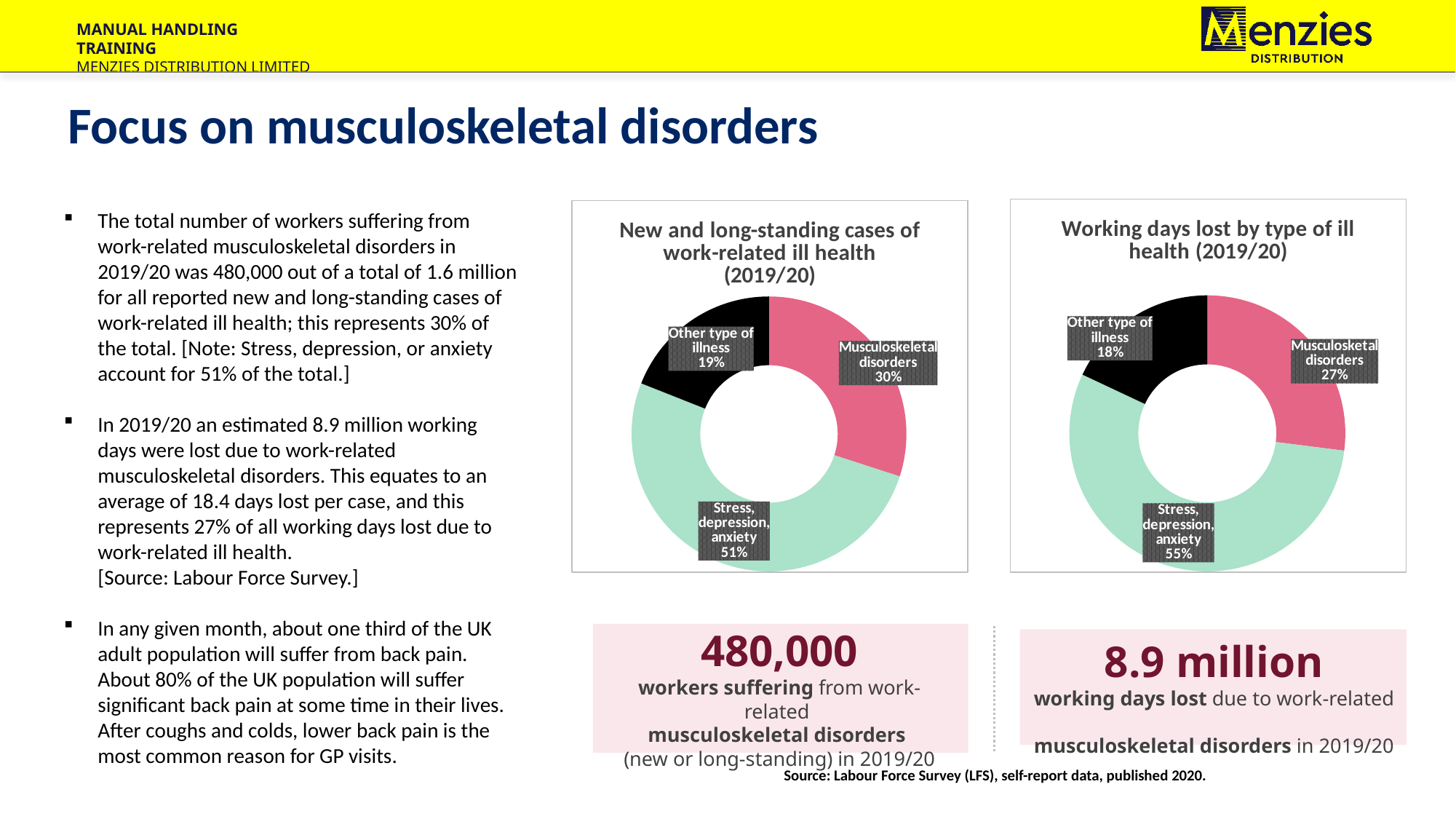
In the 'Working days lost by type of ill health (2019/20)' chart, what share is shown for Musculoskeletal disorders? 27% In the 'Working days lost by type of ill health (2019/20)' chart, which category has the smallest share? Other type of illness In the 'Working days lost by type of ill health (2019/20)' chart, what share is shown for Other type of illness? 18% In the 'New and long-standing cases of work-related ill health (2019/20)' chart, what share is shown for Other type of illness? 19% What type of chart is the 'New and long-standing cases of work-related ill health (2019/20)' chart? Doughnut chart In the 'New and long-standing cases of work-related ill health (2019/20)' chart, what share is shown for Musculoskeletal disorders? 30% In the 'New and long-standing cases of work-related ill health (2019/20)' chart, what share is shown for Stress, depression, anxiety? 51% In the 'Working days lost by type of ill health (2019/20)' chart, what is the difference in percentage points between Stress, depression, anxiety and Musculoskeletal disorders? 28 How many categories are shown in the 'Working days lost by type of ill health (2019/20)' chart? 3 In the 'Working days lost by type of ill health (2019/20)' chart, what share is shown for Stress, depression, anxiety? 55% In the 'New and long-standing cases of work-related ill health (2019/20)' chart, which category has the largest share? Stress, depression, anxiety In the 'New and long-standing cases of work-related ill health (2019/20)' chart, which is larger: Musculoskeletal disorders or Other type of illness? Musculoskeletal disorders